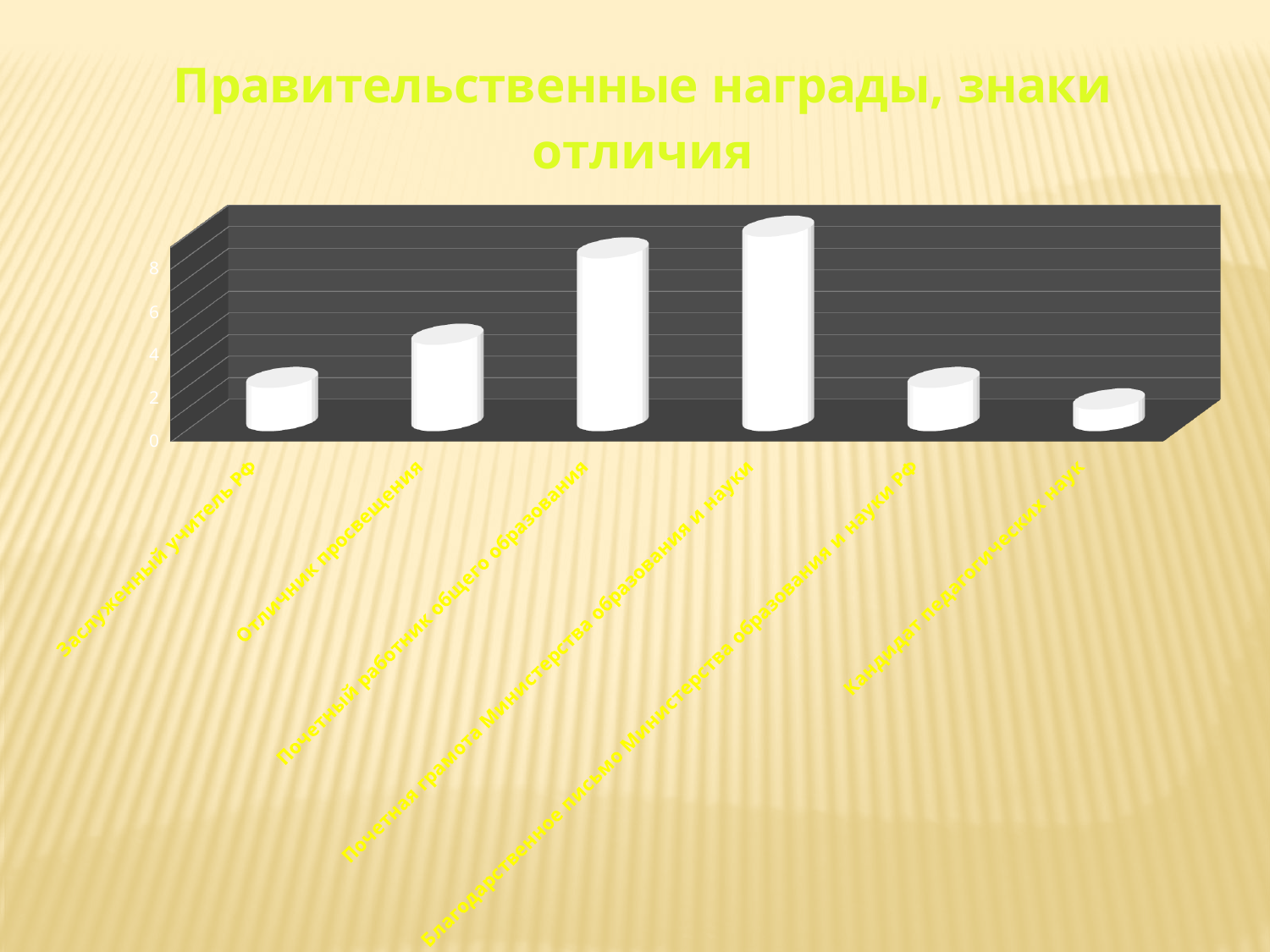
What is the highest tick value shown on the vertical axis? 8 Is the value for Благодарственное письмо Министерства образования и науки РФ greater or less than 6? less Which is larger, the value for Почетная грамота Министерства образования и науки or the value for Благодарственное письмо Министерства образования и науки РФ? Почетная грамота Министерства образования и науки What is the title of the chart? Правительственные награды, знаки отличия Which category has the highest value? Почетная грамота Министерства образования и науки Is the value for Отличник просвещения greater or less than 2? greater Is the value for Заслуженный учитель РФ greater or less than 4? less What kind of chart is shown on the slide? bar chart Which category has the lowest value? Кандидат педагогических наук How many categories are plotted in the chart? 6 Which is larger, the value for Почетный работник общего образования or the value for Отличник просвещения? Почетный работник общего образования